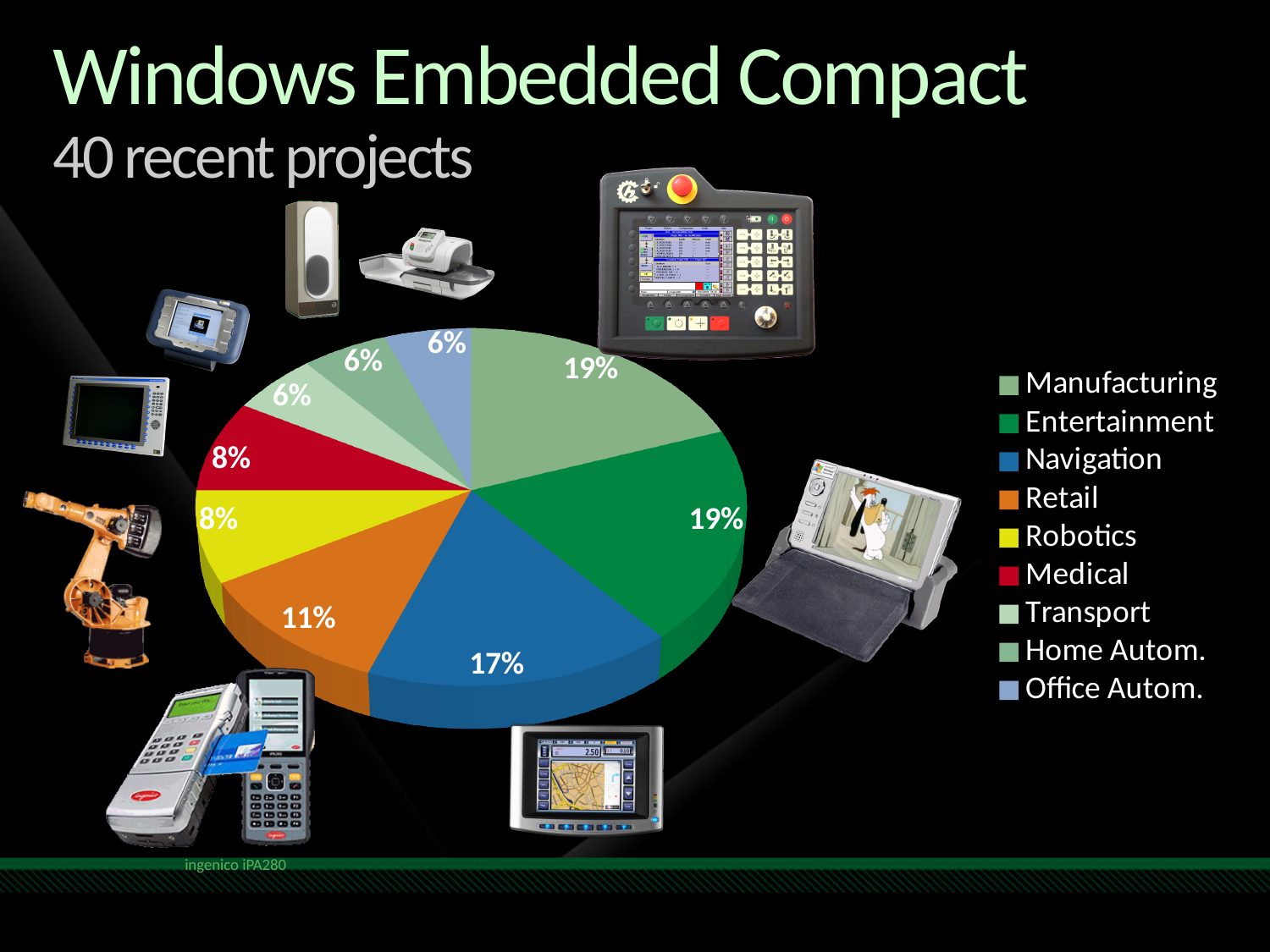
What percentage of projects does the Office Autom. slice represent? 6% Which is larger, the Robotics slice or the Entertainment slice? Entertainment Which is larger, the Navigation slice or the Retail slice? Navigation What percentage of projects does the Medical slice represent? 8% Which legend entry is shown in red? Medical How many categories does the pie chart show? 9 What kind of chart is shown on the slide? Pie chart What percentage of projects does the Navigation slice represent? 17% What percentage of projects does the Retail slice represent? 11% What percentage of projects does the Manufacturing slice represent? 19% What is the difference in percentage points between the Entertainment slice and the Navigation slice? 2% What is the difference in percentage points between the Retail slice and the Robotics slice? 3%